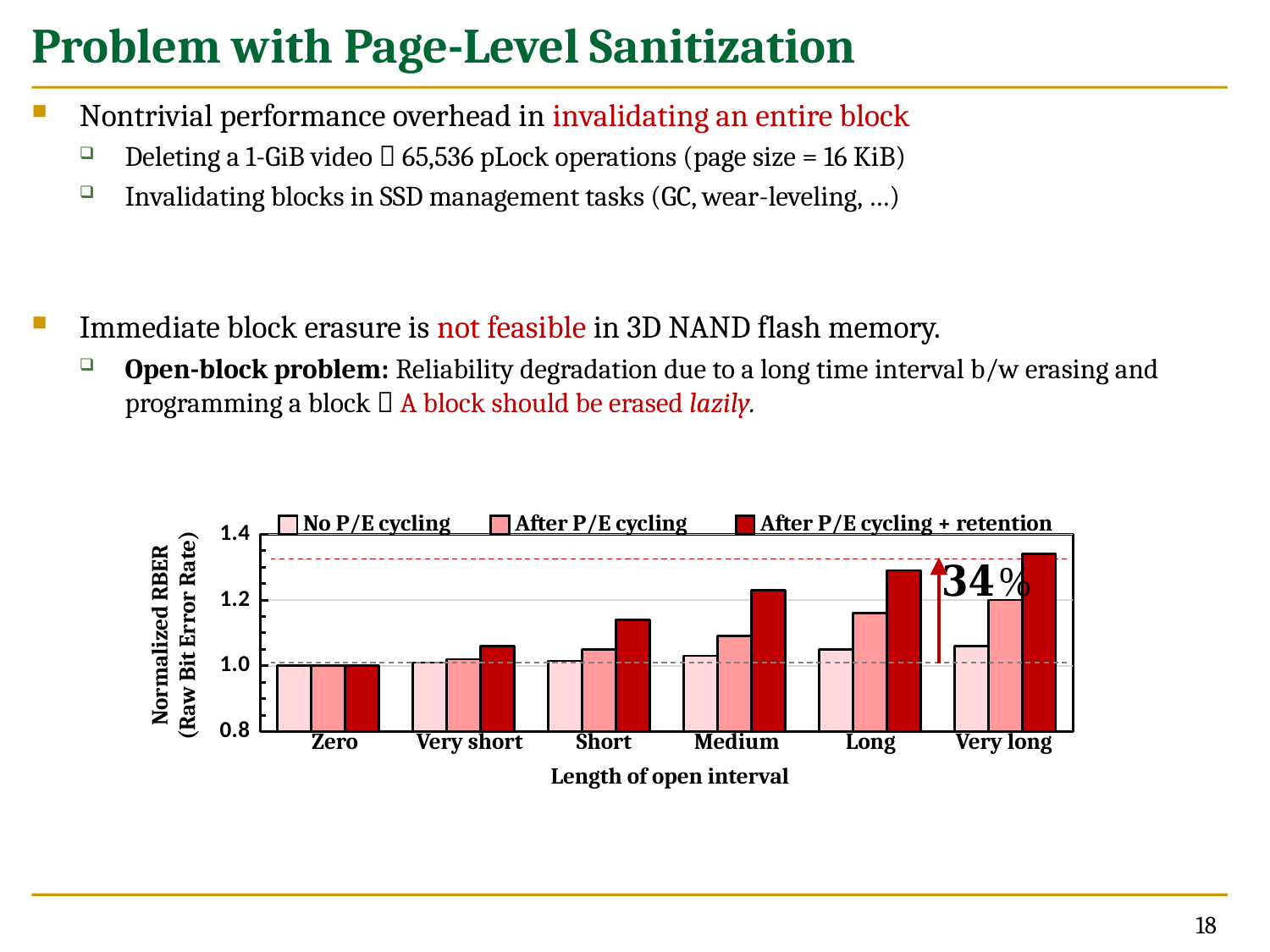
Do the 'After P/E cycling + retention' values rise or fall as the length of the open interval increases? rise For the 'Very long' open interval, which series has the larger value: 'No P/E cycling' or 'After P/E cycling + retention'? After P/E cycling + retention Is the 'After P/E cycling + retention' value for 'Short' greater or less than 1.2? less Is the 'After P/E cycling' value for 'Long' greater or less than 1.2? less What is the title of the x axis of the chart? Length of open interval How many series does the legend list? 3 What is the normalized RBER for the 'After P/E cycling + retention' series at the 'Zero' open interval? 1.0 Is the 'After P/E cycling + retention' value for 'Very long' greater or less than 1.2? greater What is the normalized RBER for the 'No P/E cycling' series at the 'Zero' open interval? 1.0 What kind of chart is shown on the slide? bar chart How many categories are shown along the x axis? 6 Which open interval length has the highest 'After P/E cycling + retention' value? Very long